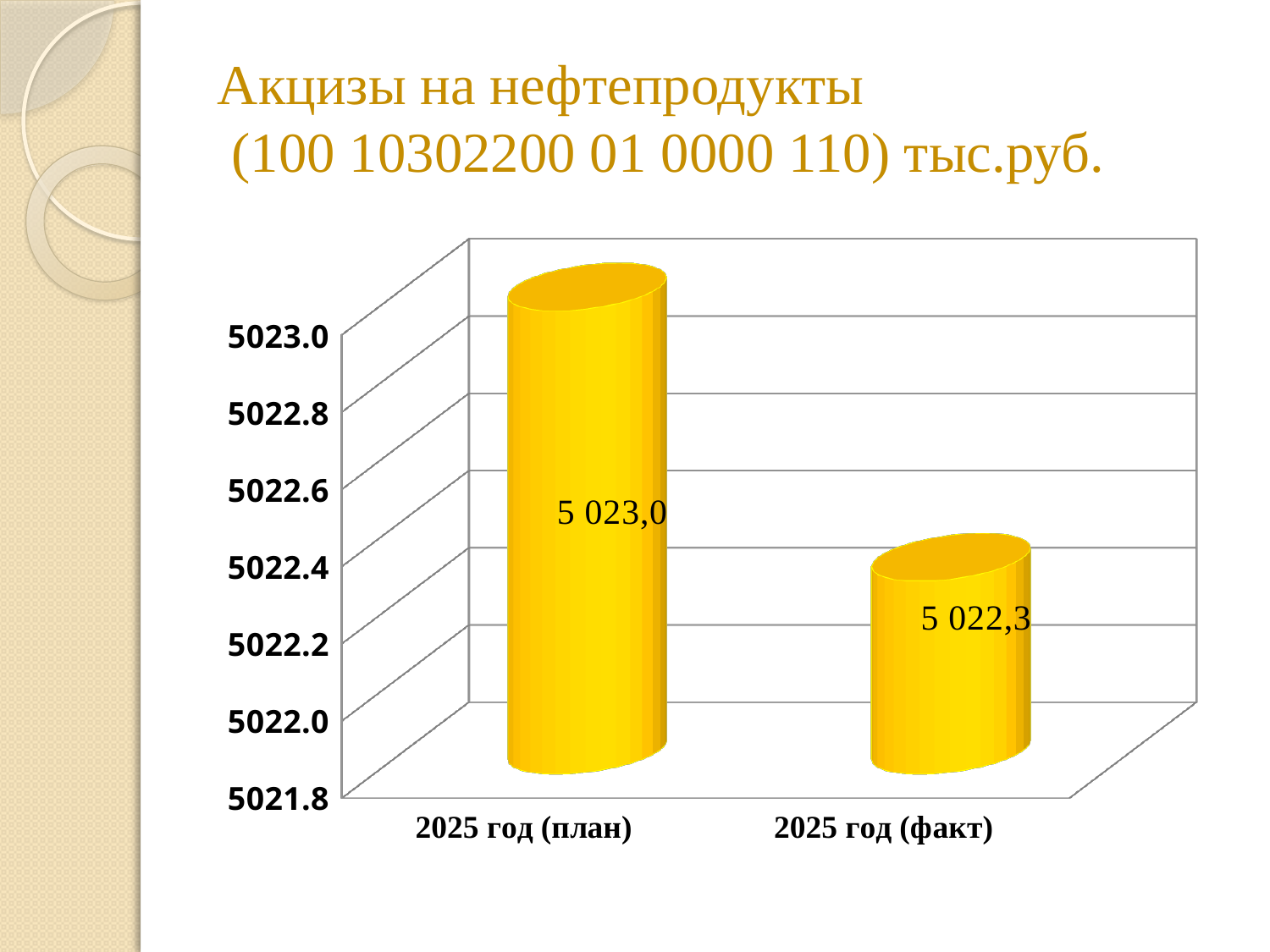
What is the difference between the value for 2025 год (план) and the value for 2025 год (факт)? 0,7 Is the value for 2025 год (факт) greater or less than 5022.6? less Which category has the highest value? 2025 год (план) Is the value for 2025 год (план) greater or less than 5022.8? greater What is the value for 2025 год (план)? 5 023,0 Which is larger: the value for 2025 год (план) or the value for 2025 год (факт)? 2025 год (план) Which category has the lowest value? 2025 год (факт) How many categories are shown on the x axis? 2 What is the title of the slide? Акцизы на нефтепродукты (100 10302200 01 0000 110) тыс.руб. Do the values rise or fall from 2025 год (план) to 2025 год (факт)? fall What is the value for 2025 год (факт)? 5 022,3 What kind of chart is shown on the slide? bar chart